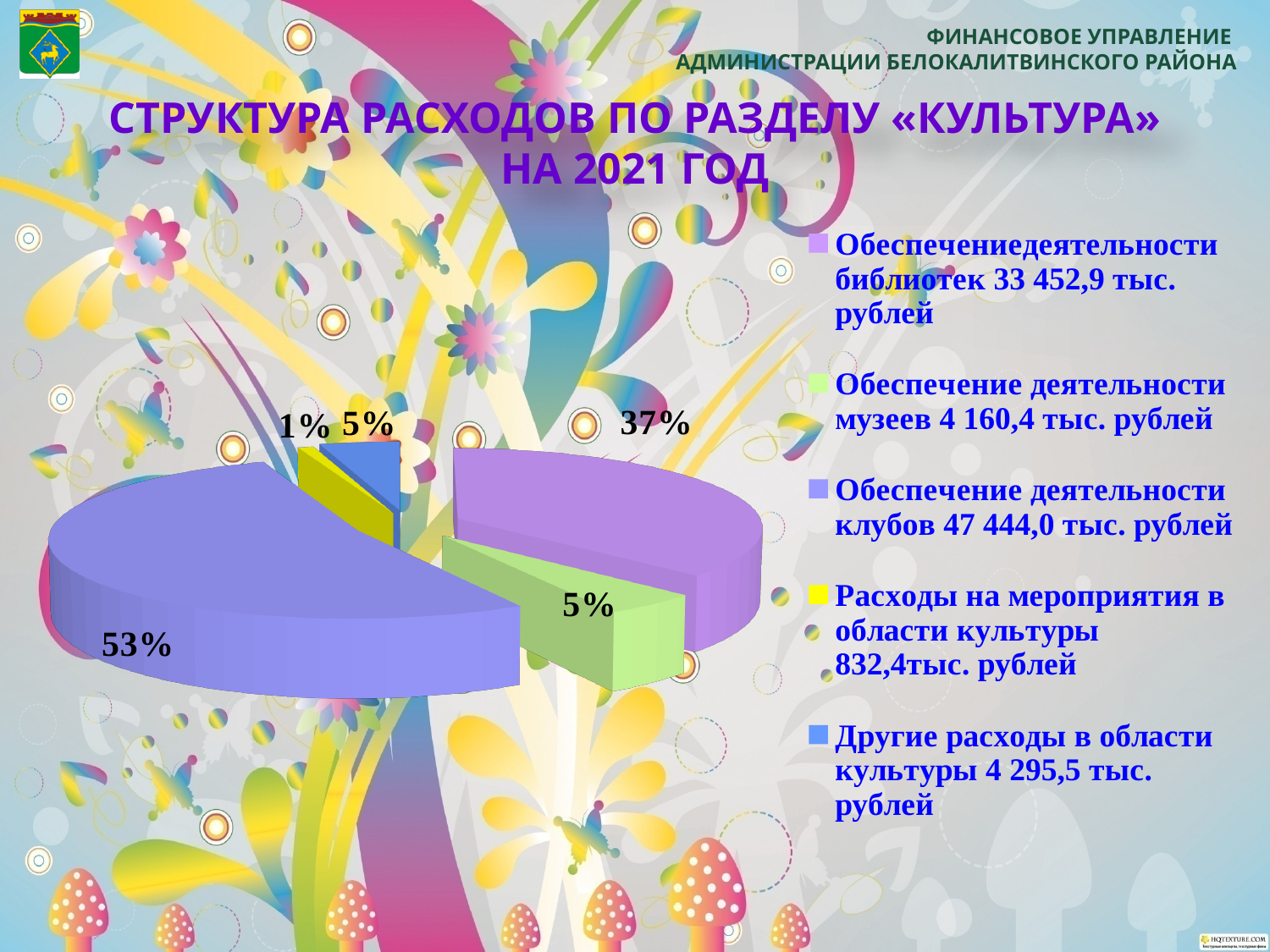
By how many percentage points does the clubs slice (53%) exceed the libraries slice (37%)? 16 percentage points Which category has the smallest slice of the pie? Расходы на мероприятия в области культуры What share of the pie is taken by "Обеспечение деятельности библиотек"? 37% Which category has the largest slice of the pie? Обеспечение деятельности клубов What share of the pie is taken by "Обеспечение деятельности клубов"? 53% What is the title of the chart slide? СТРУКТУРА РАСХОДОВ ПО РАЗДЕЛУ «КУЛЬТУРА» НА 2021 ГОД What kind of chart is shown on the slide? pie chart What amount in thousand rubles is given in the legend for "Обеспечение деятельности музеев"? 4 160,4 тыс. рублей What share of the pie is taken by "Расходы на мероприятия в области культуры"? 1% How many entries does the legend list? 5 What amount in thousand rubles is given in the legend for "Другие расходы в области культуры"? 4 295,5 тыс. рублей How many slices does the pie chart have? 5